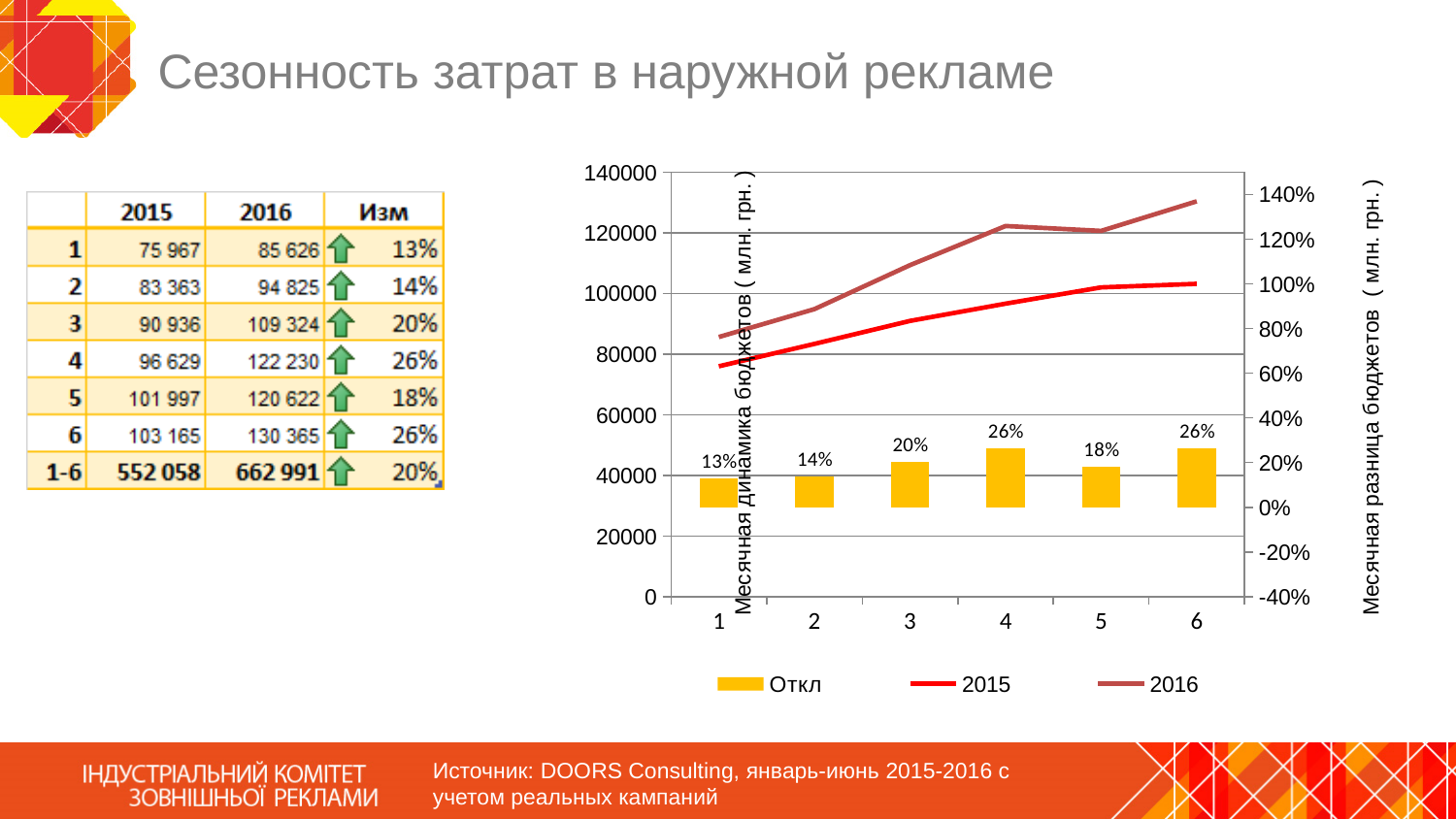
Which category has the lowest Откл bar? 1 What is the difference between the Откл values for category 4 and category 1? 13% Is the value of the 2015 line at category 1 greater or less than 80000? less How many series does the chart legend list? 3 Which is larger, the Откл value for category 3 or for category 5? category 3 What is the value of the Откл bar for category 1? 13% Does the 2015 line rise or fall from category 1 to category 6? rises How many categories are shown on the x axis of the chart? 6 At category 6, which line is higher, 2015 or 2016? 2016 What is the value of the Откл bar for category 4? 26% What is the value of the Откл bar for category 5? 18% Is the value of the 2016 line at category 6 greater or less than 120000? greater